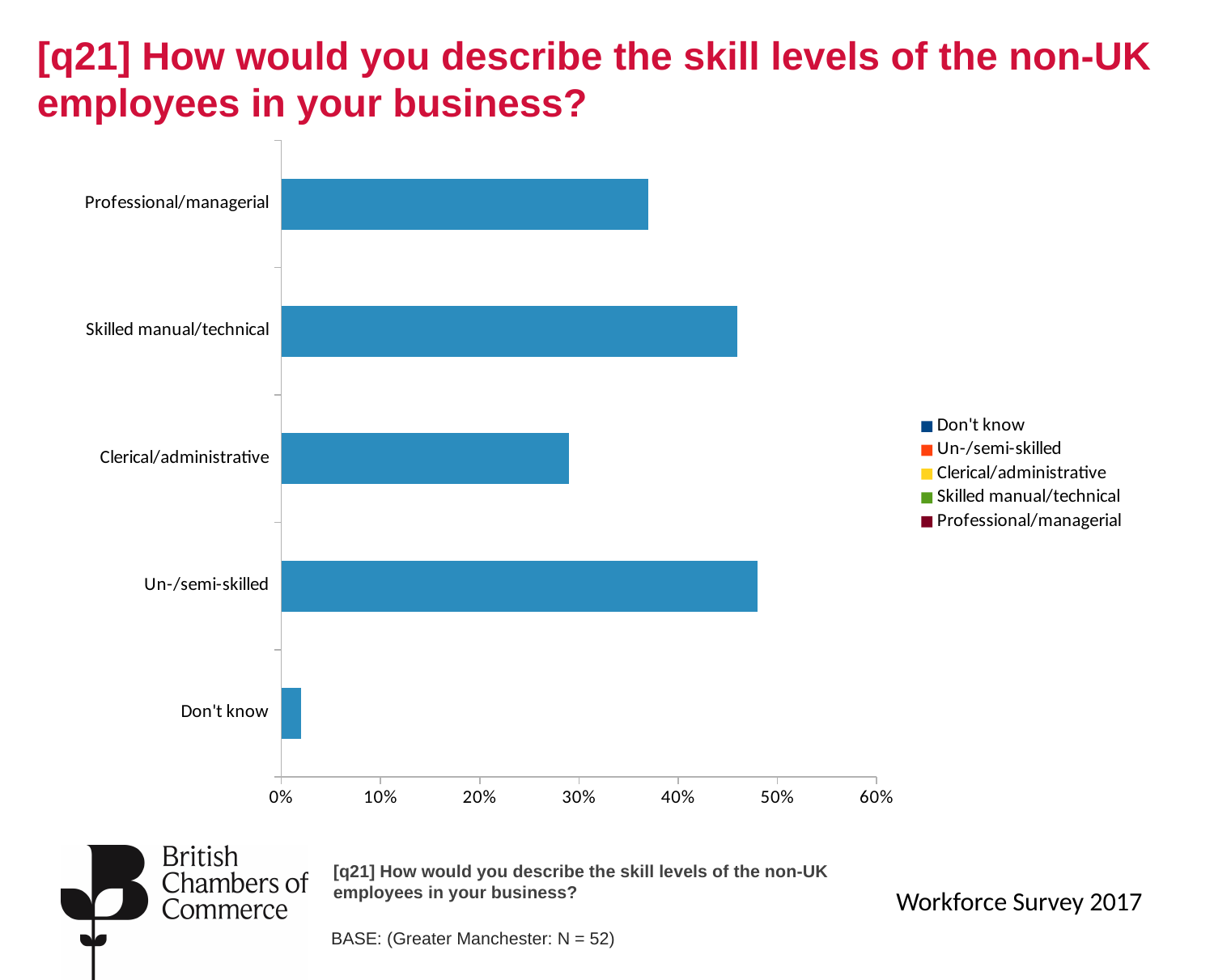
How many entries does the legend list? 5 Is the value for Professional/managerial greater or less than 30%? greater Is the value for Don't know greater or less than 10%? less What kind of chart is shown on the slide? bar chart Is the value for Un-/semi-skilled greater or less than 40%? greater Which is larger, the value for Skilled manual/technical or the value for Clerical/administrative? Skilled manual/technical Which is larger, the value for Un-/semi-skilled or the value for Professional/managerial? Un-/semi-skilled What is the highest value shown on the horizontal axis? 60% Which category has the lowest value? Don't know How many categories are plotted on the chart? 5